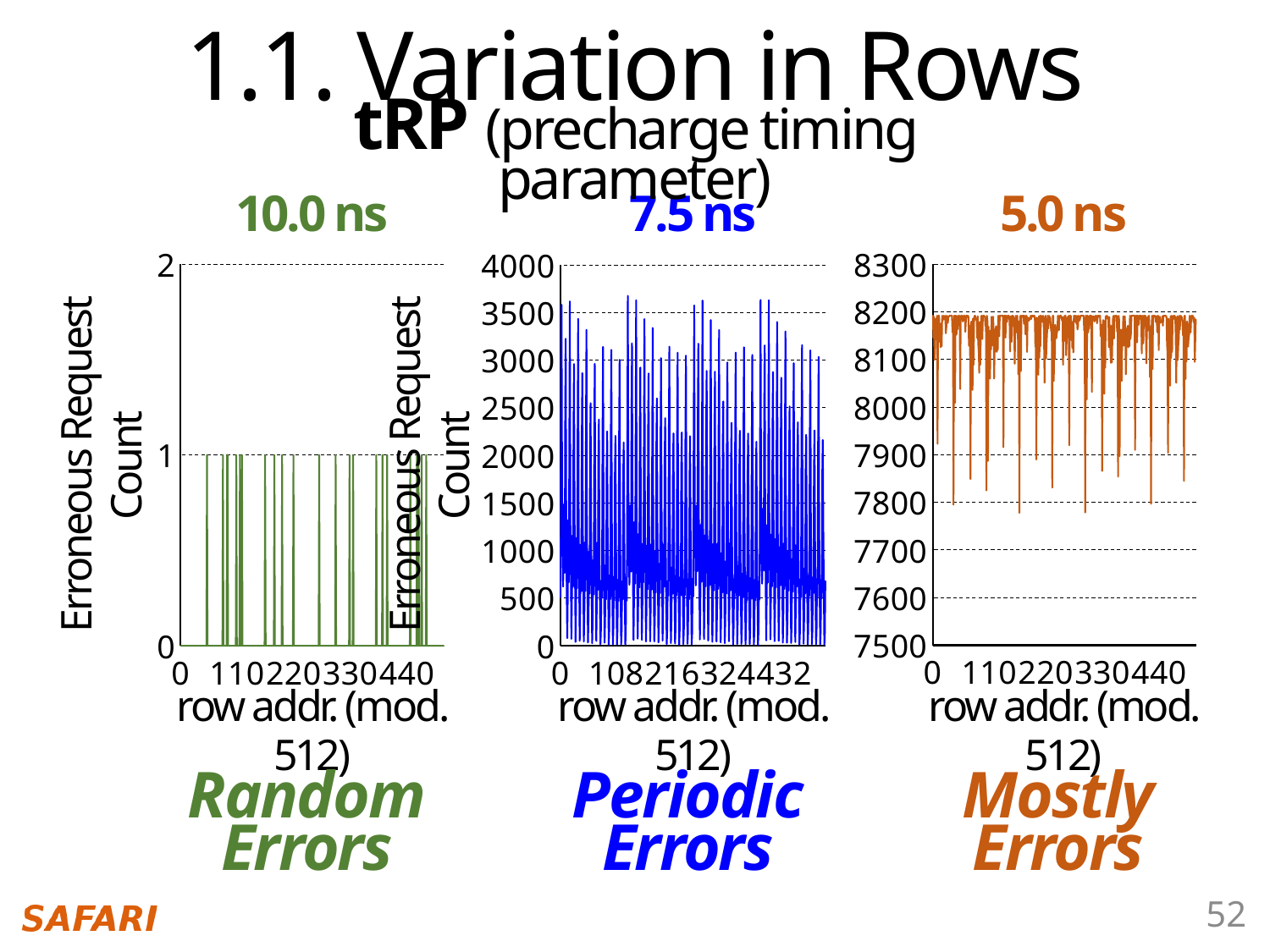
In the 7.5 ns chart, is the highest erroneous request count greater or less than 3000? greater What is the title above the leftmost chart? 10.0 ns How many charts are shown on the slide? 3 What label is written beneath the 7.5 ns chart? Periodic Errors In the 5.0 ns chart, are the erroneous request counts greater or less than 7500? greater Which of the three charts has the highest erroneous request counts? 5.0 ns In the 7.5 ns chart, is the highest erroneous request count greater or less than 4000? less In the 10.0 ns chart, what is the highest erroneous request count reached by any row? 1 Which of the three charts has the lowest erroneous request counts? 10.0 ns Which chart shows higher erroneous request counts, the 7.5 ns chart or the 5.0 ns chart? 5.0 ns What kind of chart is the 10.0 ns chart? line chart